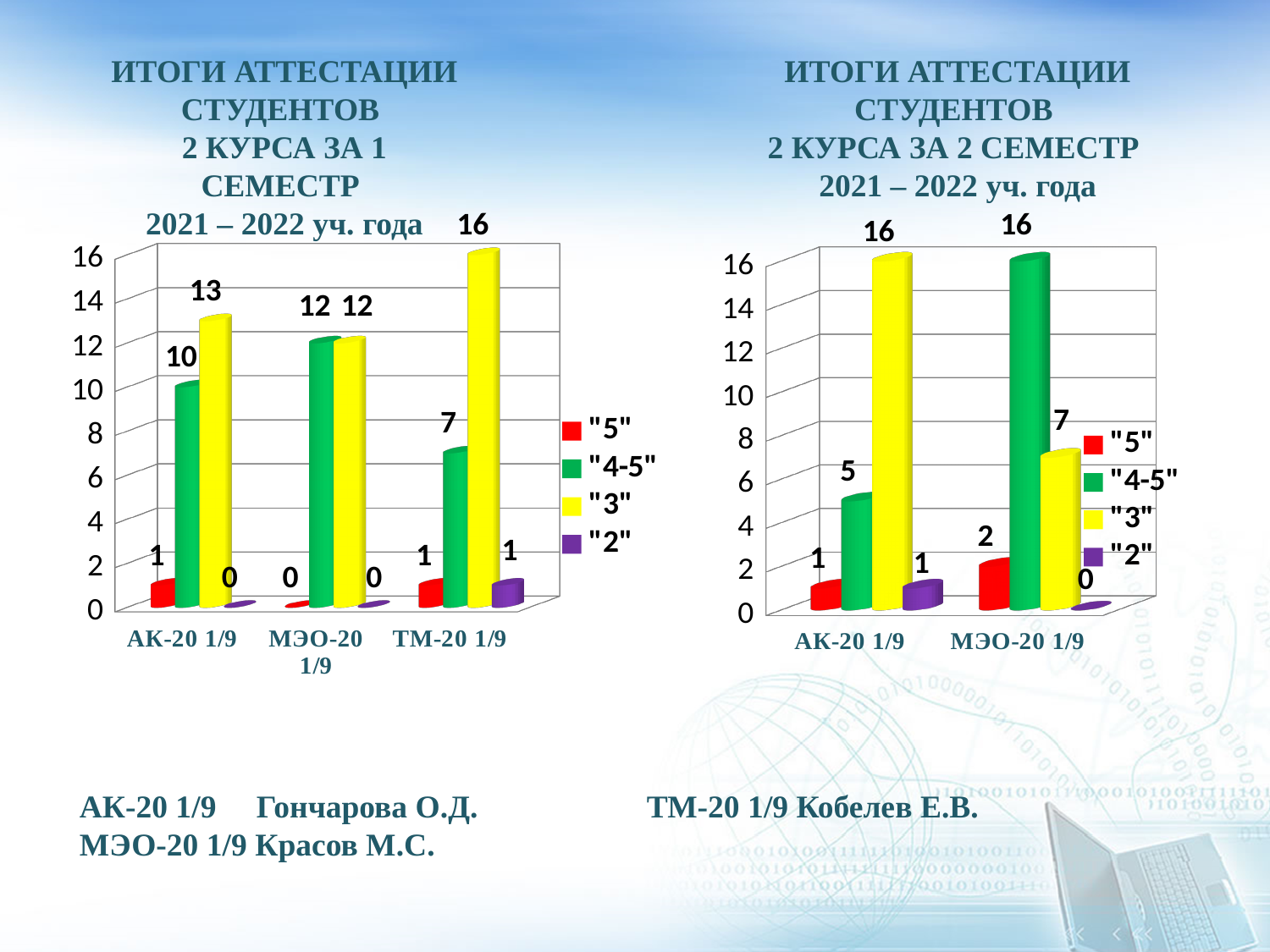
In the left chart (1st semester), what is the difference between the "3" value for ТМ-20 1/9 and the "3" value for МЭО-20 1/9? 4 In the left chart (1st semester), what is the value of the "3" series for АК-20 1/9? 13 What type of chart is the right chart (2nd semester)? bar chart In the right chart (2nd semester), which category has the lowest value for the "4-5" series? АК-20 1/9 In the right chart (2nd semester), which is larger for АК-20 1/9: the "4-5" value or the "3" value? "3" In the left chart (1st semester), what is the value of the "4-5" series for ТМ-20 1/9? 7 In the left chart (1st semester), which category has the highest value for the "3" series? ТМ-20 1/9 How many series does the legend of the right chart (2nd semester) list? 4 In the right chart (2nd semester), what is the value of the "5" series for МЭО-20 1/9? 2 In the right chart (2nd semester), what is the value of the "4-5" series for МЭО-20 1/9? 16 In the left chart (1st semester), what is the total of all four series for ТМ-20 1/9? 25 How many categories are shown on the x axis of the left chart (1st semester)? 3